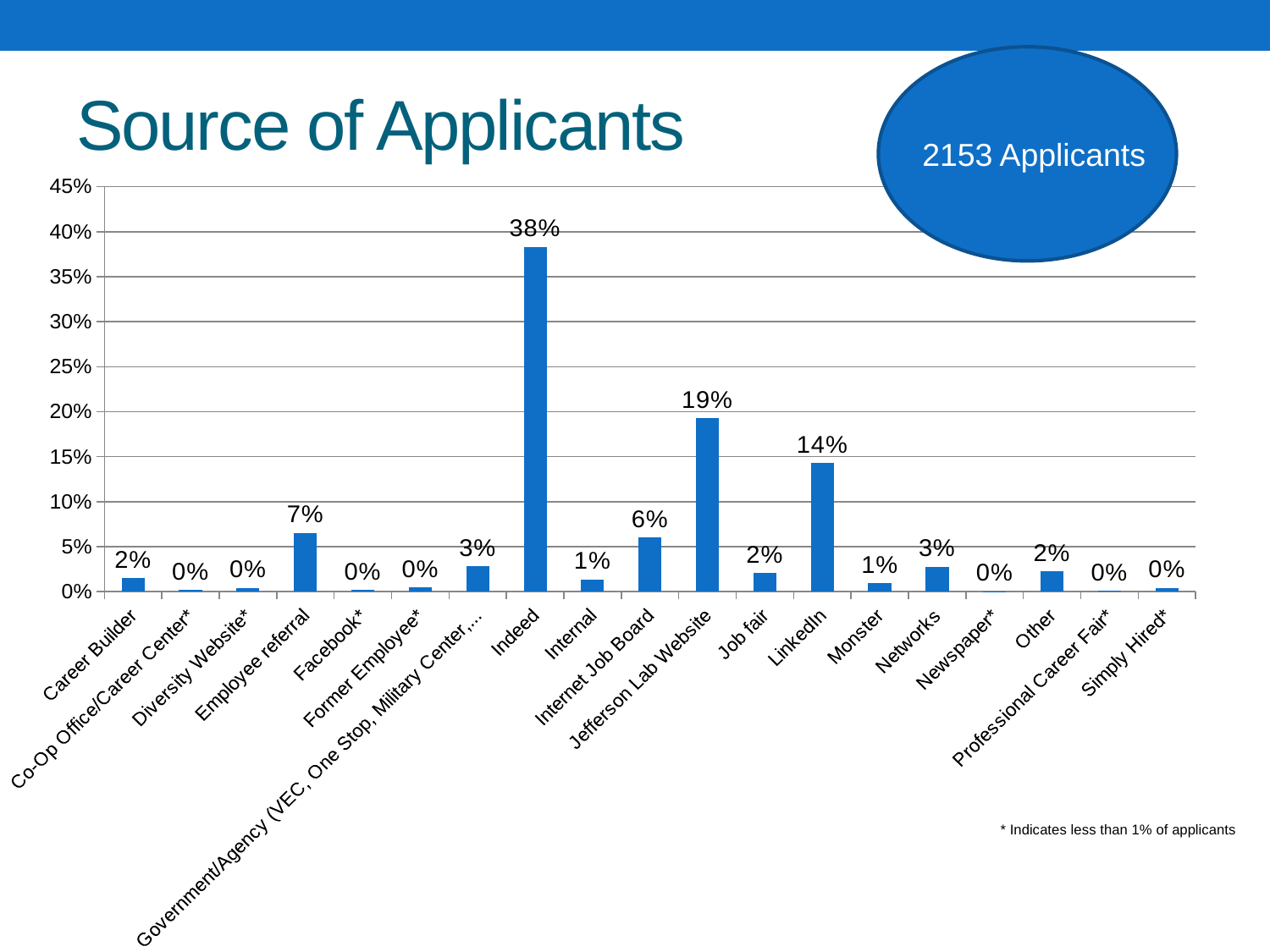
Which is larger, the value for Employee referral or the value for Internet Job Board? Employee referral Is the value for Indeed greater or less than 35%? greater How many source categories are shown on the x axis? 19 What percentage of applicants came from Indeed? 38% What is the value shown for Jefferson Lab Website? 19% What percentage of applicants came from LinkedIn? 14% What is the value shown for Employee referral? 7% What percentage of applicants came from Internet Job Board? 6% What is the difference between Jefferson Lab Website and LinkedIn? 5% What kind of chart is shown on the slide? Bar chart Which source has the highest percentage of applicants? Indeed What is the difference in percentage points between Indeed and Jefferson Lab Website? 19%